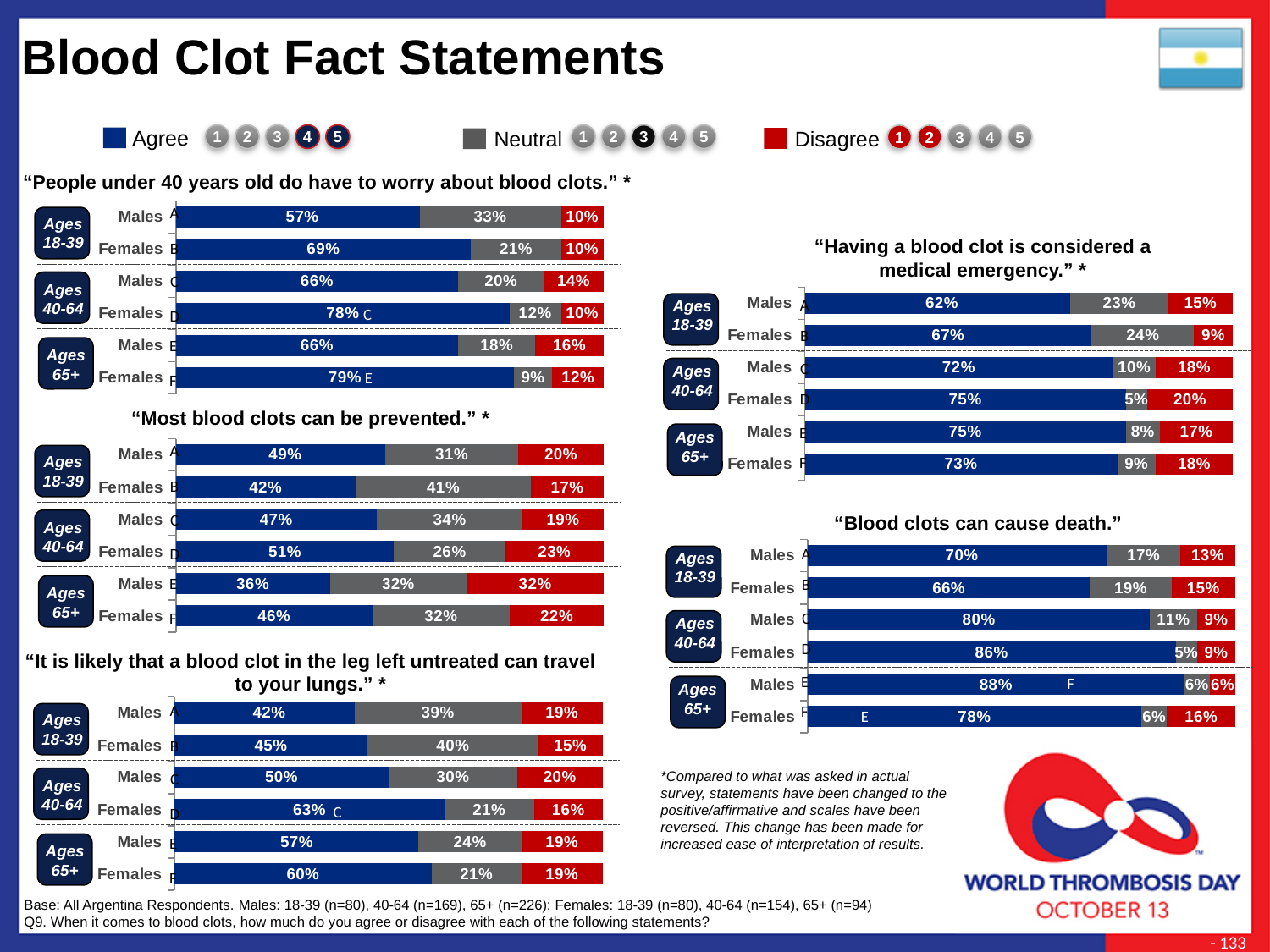
In the "Having a blood clot is considered a medical emergency" chart, what is the Disagree percentage for Females aged 40-64? 20% In the "Most blood clots can be prevented" chart, what is the Disagree percentage for Males aged 65+? 32% In the "It is likely that a blood clot in the leg left untreated can travel to your lungs" chart, what is the difference between the Agree percentages of Females 40-64 and Males 40-64? 13% What kind of chart is used for the "Blood clots can cause death" statement? Stacked bar chart In the "It is likely that a blood clot in the leg left untreated can travel to your lungs" chart, what is the Neutral percentage for Females aged 18-39? 40% In the "Blood clots can cause death" chart, which group has the highest Agree percentage? Males 65+ In the "Most blood clots can be prevented" chart, which group has the highest Agree percentage? Females 40-64 In the "People under 40 years old do have to worry about blood clots" chart, which group has the lowest Agree percentage? Males 18-39 In the "Having a blood clot is considered a medical emergency" chart, which is larger: the Agree percentage for Males 40-64 or for Females 18-39? Males 40-64 How many series does the legend at the top of the slide list? 3 In the "Blood clots can cause death" chart, what is the Disagree percentage for Females aged 65+? 16% In the "People under 40 years old do have to worry about blood clots" chart, what percentage of Females aged 65+ agree? 79%